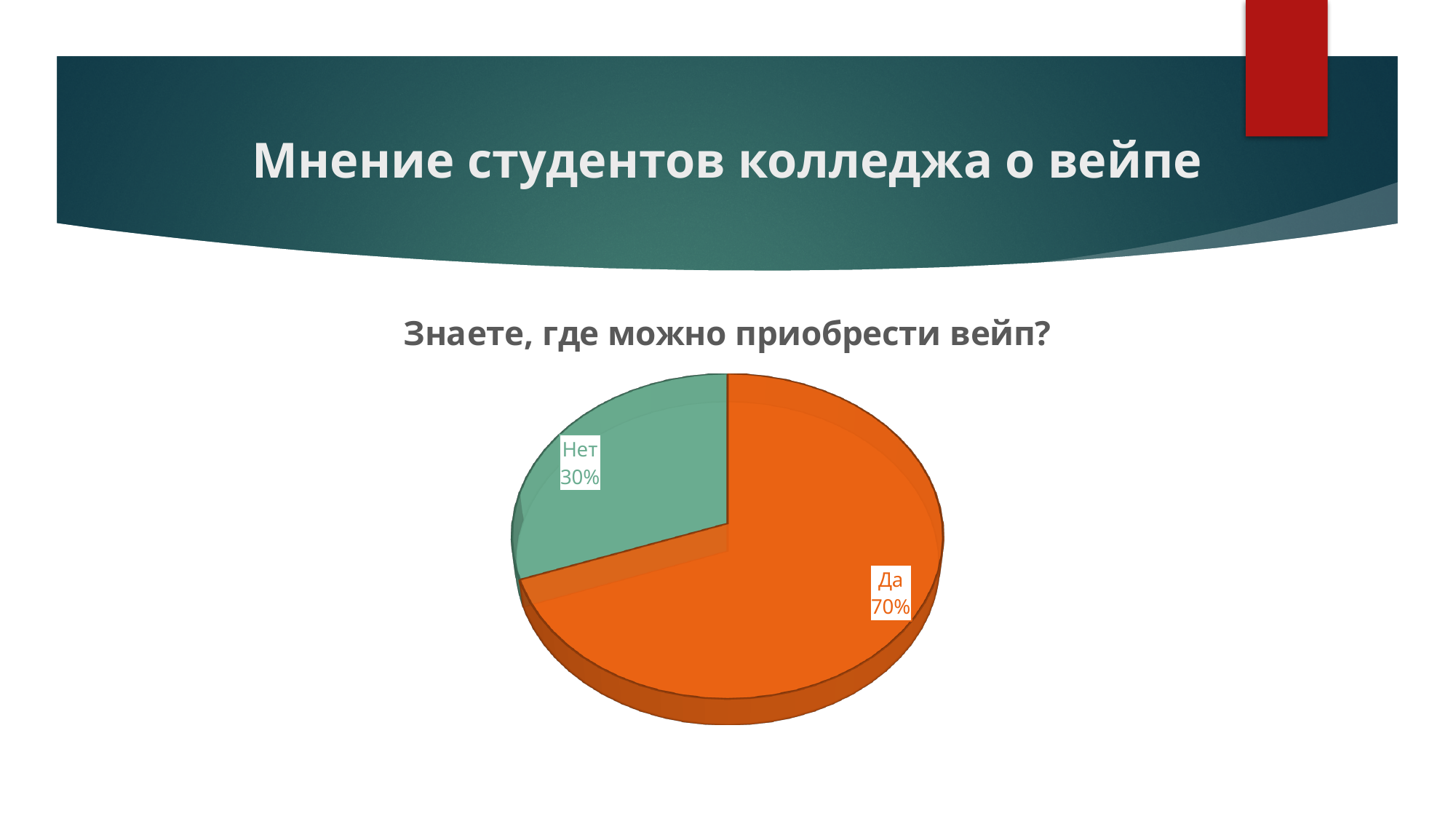
Which slice is the smallest? Нет What is the title of the chart? Знаете, где можно приобрести вейп? What colour is the "Нет" slice? Green How many slices does the pie chart have? 2 What share of the pie is labelled "Нет"? 30% Is the share for "Да" greater or less than 50%? greater What is the difference in percentage points between the "Да" and "Нет" slices? 40 Which is larger, the "Да" slice or the "Нет" slice? Да What share of the pie is labelled "Да"? 70% What kind of chart is shown on the slide? Pie chart Which slice is the largest? Да What do the two slices of the pie add up to? 100%